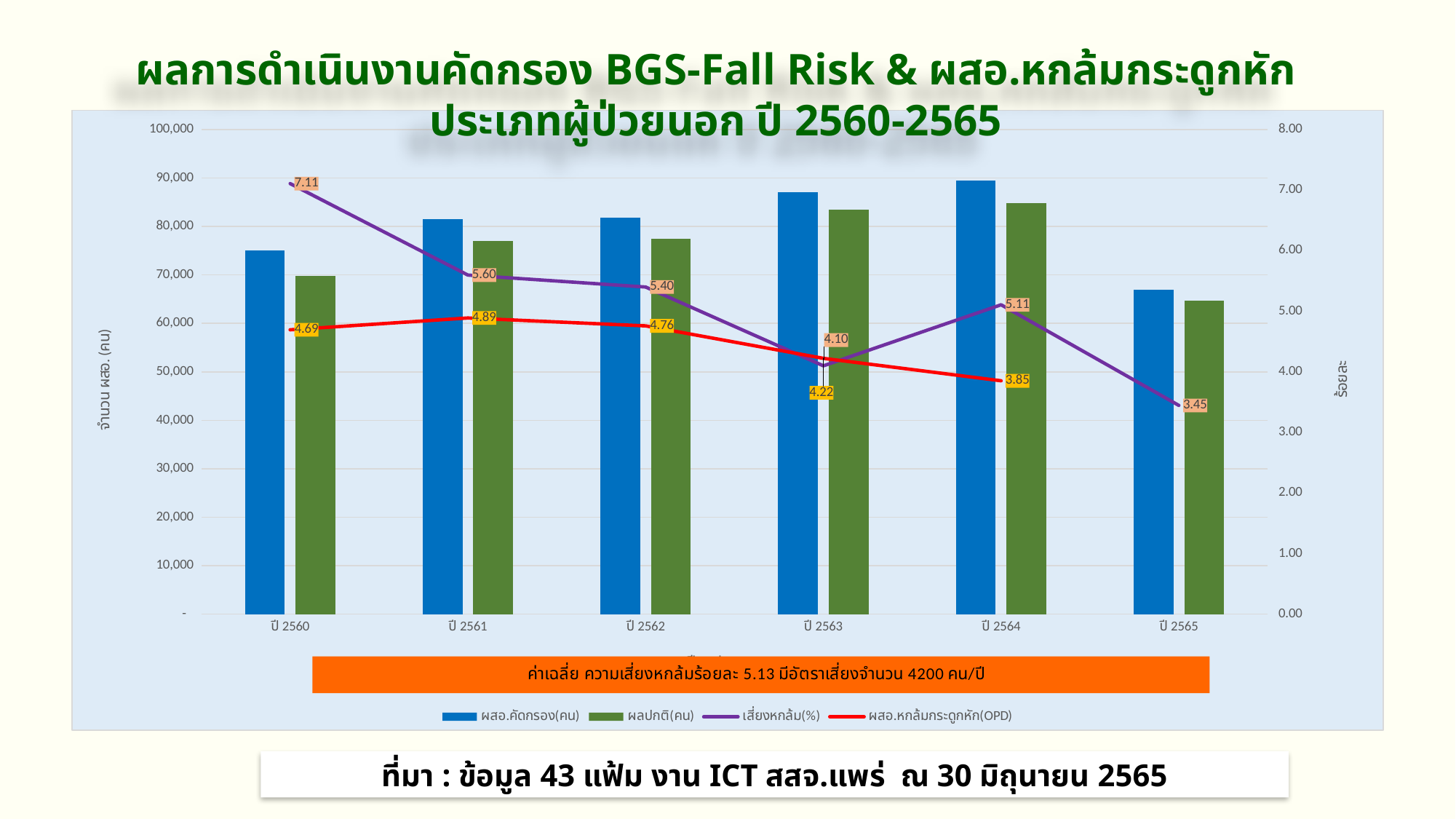
How many years are shown on the x axis? 6 Is the ผสอ.คัดกรอง(คน) bar for ปี 2564 greater or less than 80,000? greater Which year has the lowest value of เสี่ยงหกล้ม(%)? ปี 2565 What is the value of ผสอ.หกล้มกระดูกหัก(OPD) for ปี 2561? 4.89 What is the difference between the เสี่ยงหกล้ม(%) values for ปี 2560 and ปี 2565? 3.66 What is the value of เสี่ยงหกล้ม(%) for ปี 2564? 5.11 What kind of chart is this? Combination bar and line chart Which year has the highest value of เสี่ยงหกล้ม(%)? ปี 2560 How many series does the legend list? 4 For ปี 2563, which is larger: เสี่ยงหกล้ม(%) or ผสอ.หกล้มกระดูกหัก(OPD)? ผสอ.หกล้มกระดูกหัก(OPD) Is the ผลปกติ(คน) bar for ปี 2565 greater or less than 70,000? less What is the value of เสี่ยงหกล้ม(%) for ปี 2560? 7.11